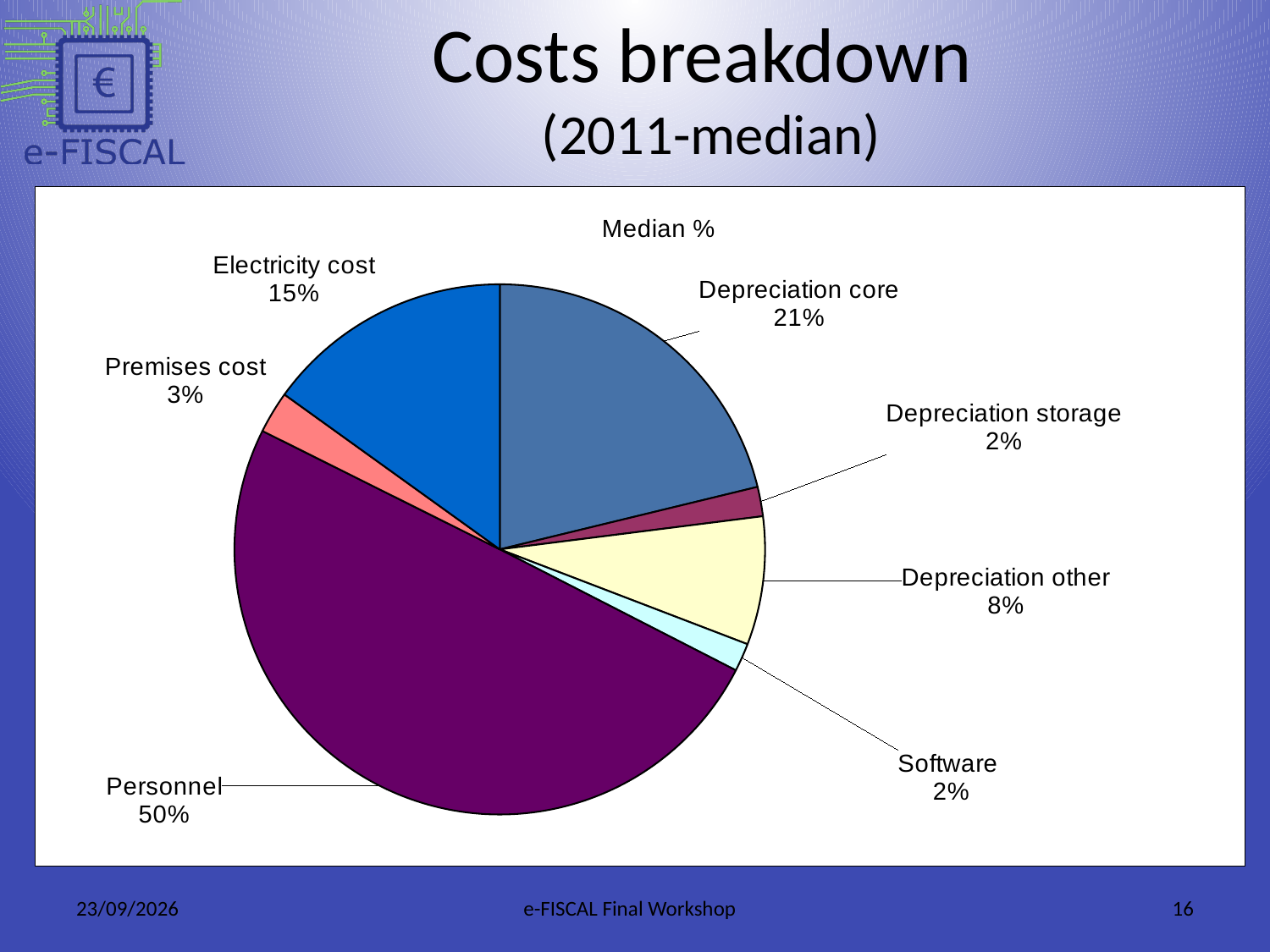
What is the title of the chart? Median % What is the value for Premises cost? 3% What is the difference between the Depreciation core and Electricity cost shares? 6% What is the value for Depreciation other? 8% What is the value for Depreciation core? 21% What is the value for Electricity cost? 15% How many slices does the pie chart have? 7 What share of the pie does Personnel account for? 50% Which category has the largest share of the pie? Personnel Which is larger, Depreciation other or Premises cost? Depreciation other What type of chart is shown on the slide? pie chart What is the difference between the Personnel and Depreciation core shares? 29%